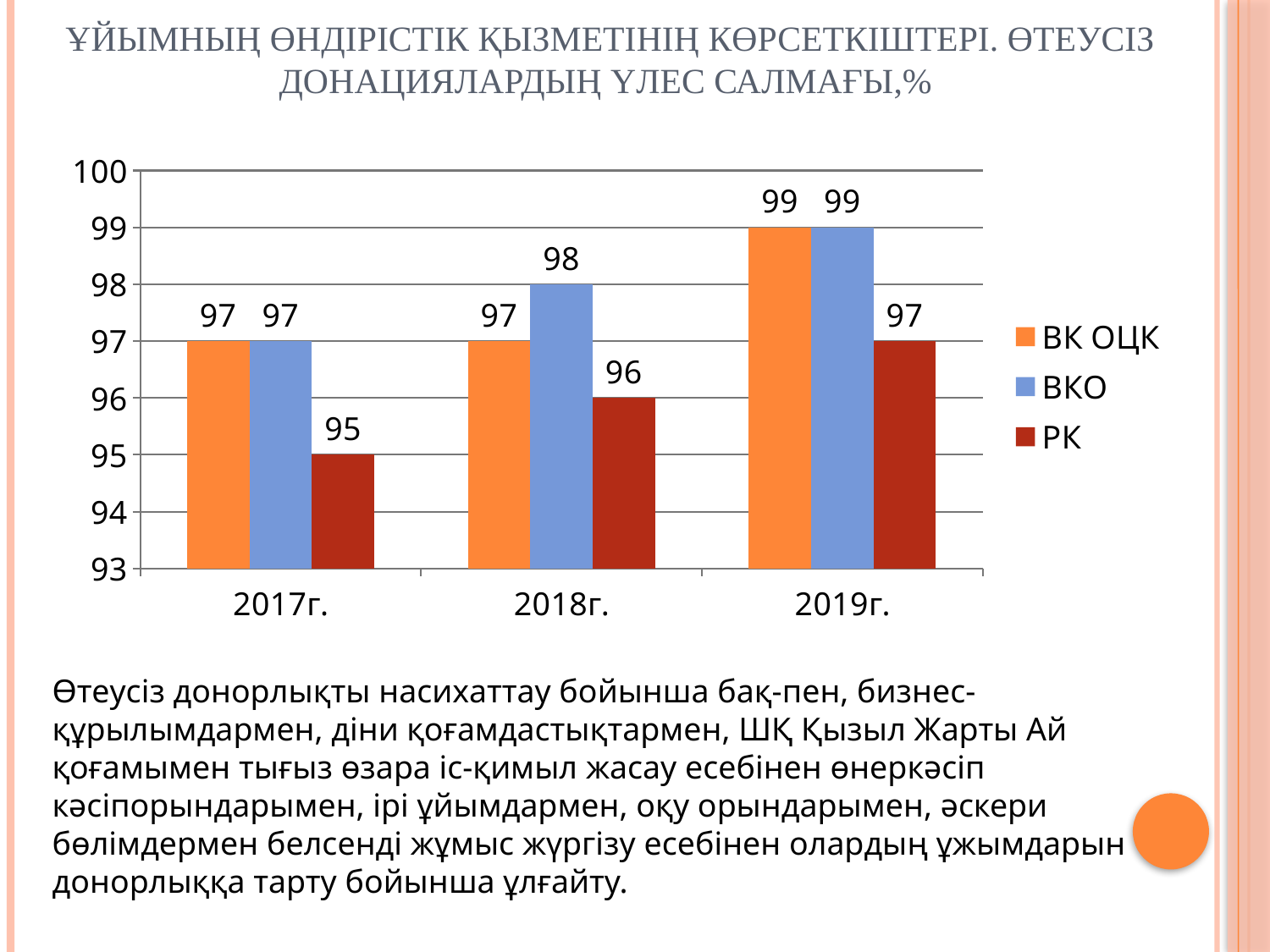
What is the value for ВКО in 2018г.? 98 What is the difference between the ВКО and РК values in 2018г.? 2 What is the value for РК in 2017г.? 95 In which year is the РК value lowest? 2017г. What kind of chart is shown on the slide? bar chart In which year is the ВКО value highest? 2019г. Do the РК values rise or fall from 2017г. to 2019г.? rise Which series is shown in dark red in the legend? РК How many series does the legend list? 3 Which is larger in 2017г., the value for ВК ОЦК or the value for РК? ВК ОЦК What is the value for ВК ОЦК in 2019г.? 99 How many years are shown on the x axis? 3